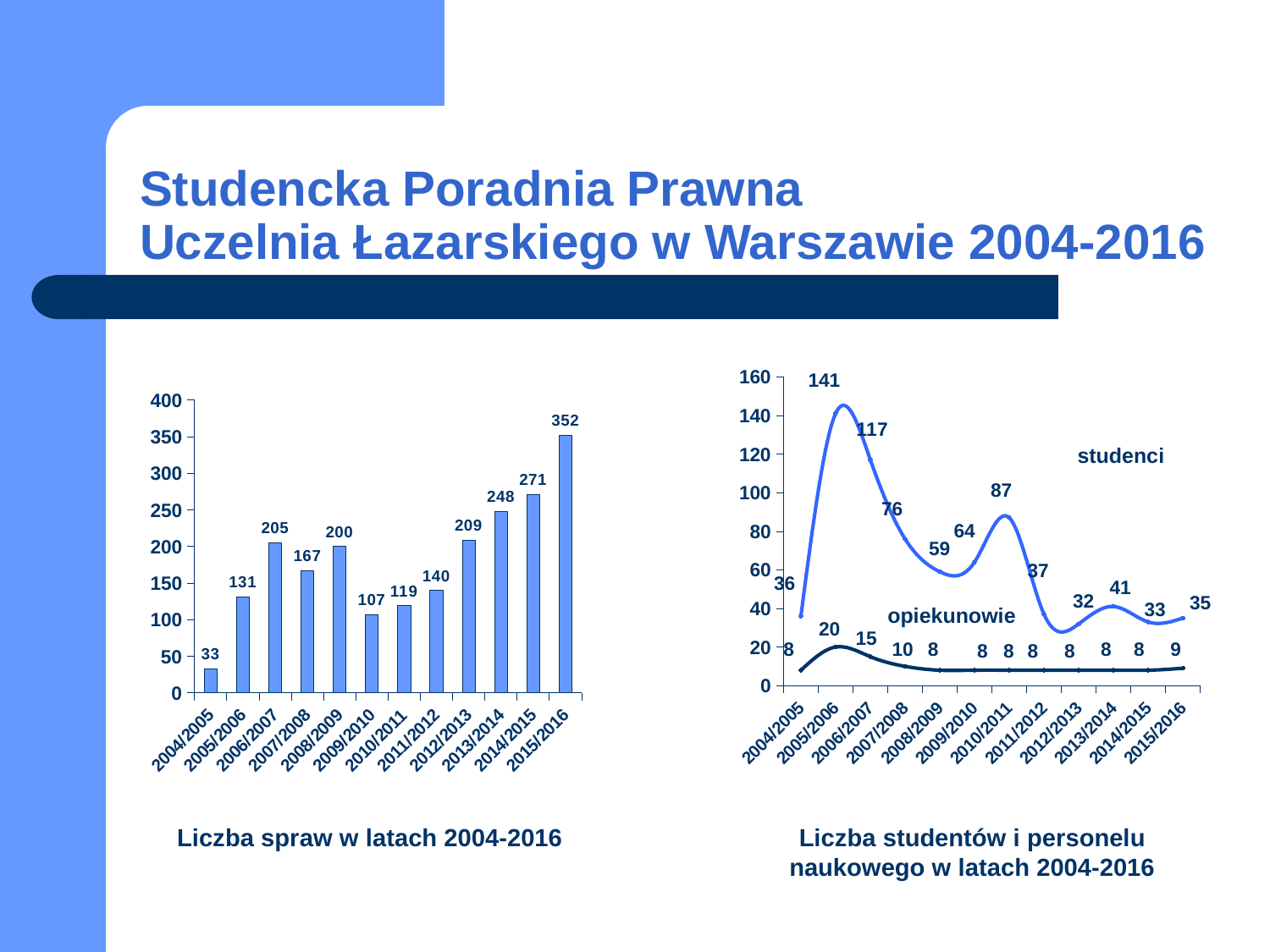
What kind of chart is the right chart (Liczba studentów i personelu naukowego w latach 2004-2016)? line chart In the left chart (Liczba spraw w latach 2004-2016), how many years are shown on the x axis? 12 In the left chart (Liczba spraw w latach 2004-2016), what is the value for 2015/2016? 352 In the right chart (Liczba studentów i personelu naukowego w latach 2004-2016), what is the value for studenci in 2005/2006? 141 In the right chart (Liczba studentów i personelu naukowego w latach 2004-2016), what is the difference between studenci and opiekunowie in 2010/2011? 79 In the right chart (Liczba studentów i personelu naukowego w latach 2004-2016), what is the value for opiekunowie in 2015/2016? 9 In the left chart (Liczba spraw w latach 2004-2016), which is larger, the value for 2006/2007 or the value for 2008/2009? 2006/2007 In the left chart (Liczba spraw w latach 2004-2016), what is the difference between the values for 2015/2016 and 2014/2015? 81 What kind of chart is the left chart (Liczba spraw w latach 2004-2016)? bar chart In the left chart (Liczba spraw w latach 2004-2016), which year has the lowest value? 2004/2005 In the right chart (Liczba studentów i personelu naukowego w latach 2004-2016), in which year is the studenci value highest? 2005/2006 In the right chart (Liczba studentów i personelu naukowego w latach 2004-2016), how many series are plotted? 2